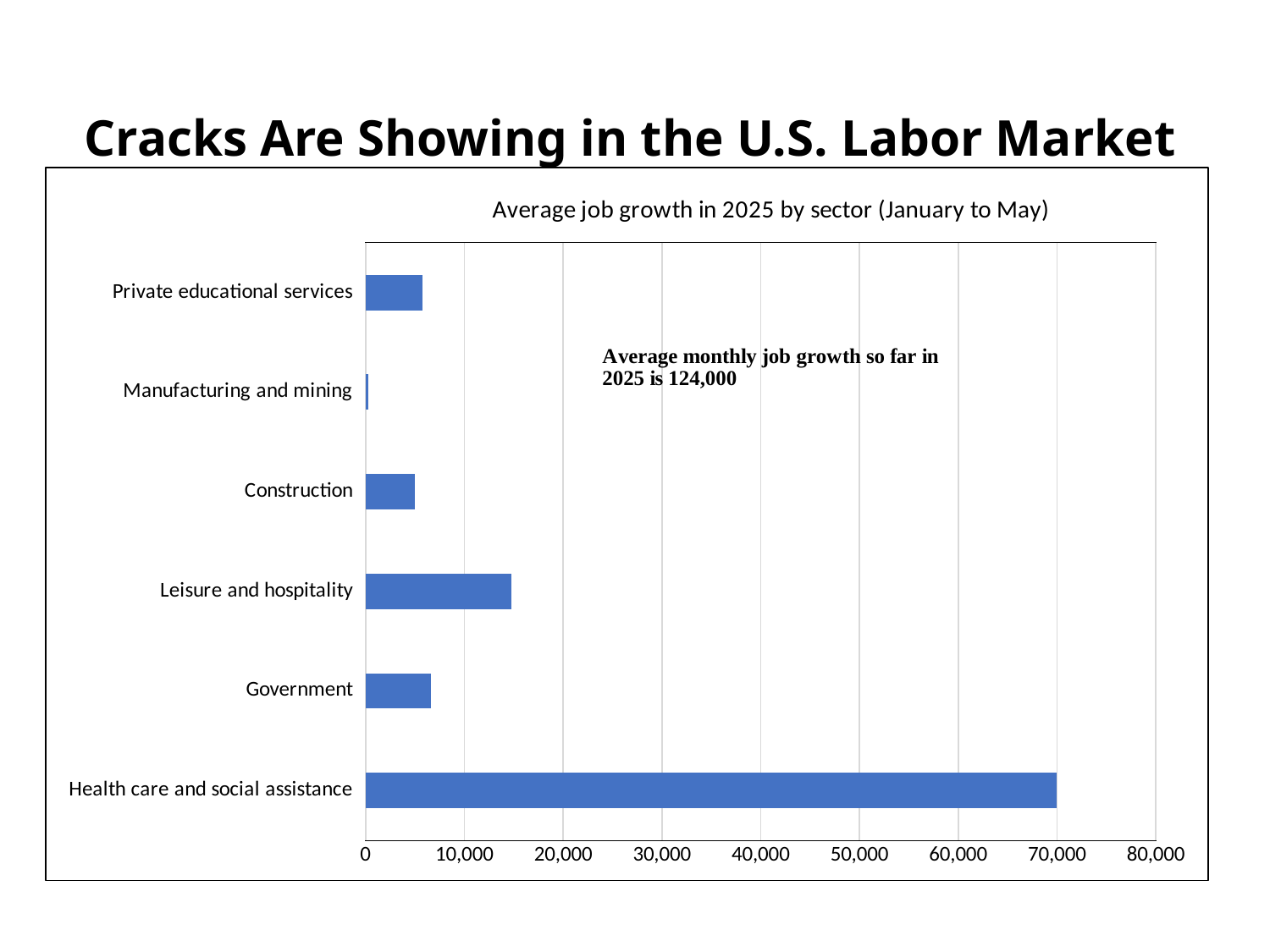
How many sectors are plotted in the chart? 6 Is the value for Government greater or less than 10,000? less Is the value for Construction greater or less than 10,000? less Which sector has the highest average job growth in the chart? Health care and social assistance According to the annotation on the chart, what is the average monthly job growth so far in 2025? 124,000 Which has the larger value, Leisure and hospitality or Government? Leisure and hospitality What kind of chart is shown on the slide? bar chart What is the title of the chart? Average job growth in 2025 by sector (January to May) Is the value for Leisure and hospitality greater or less than 10,000? greater What is the average job growth value for Health care and social assistance? 70,000 Which sector has the lowest average job growth in the chart? Manufacturing and mining